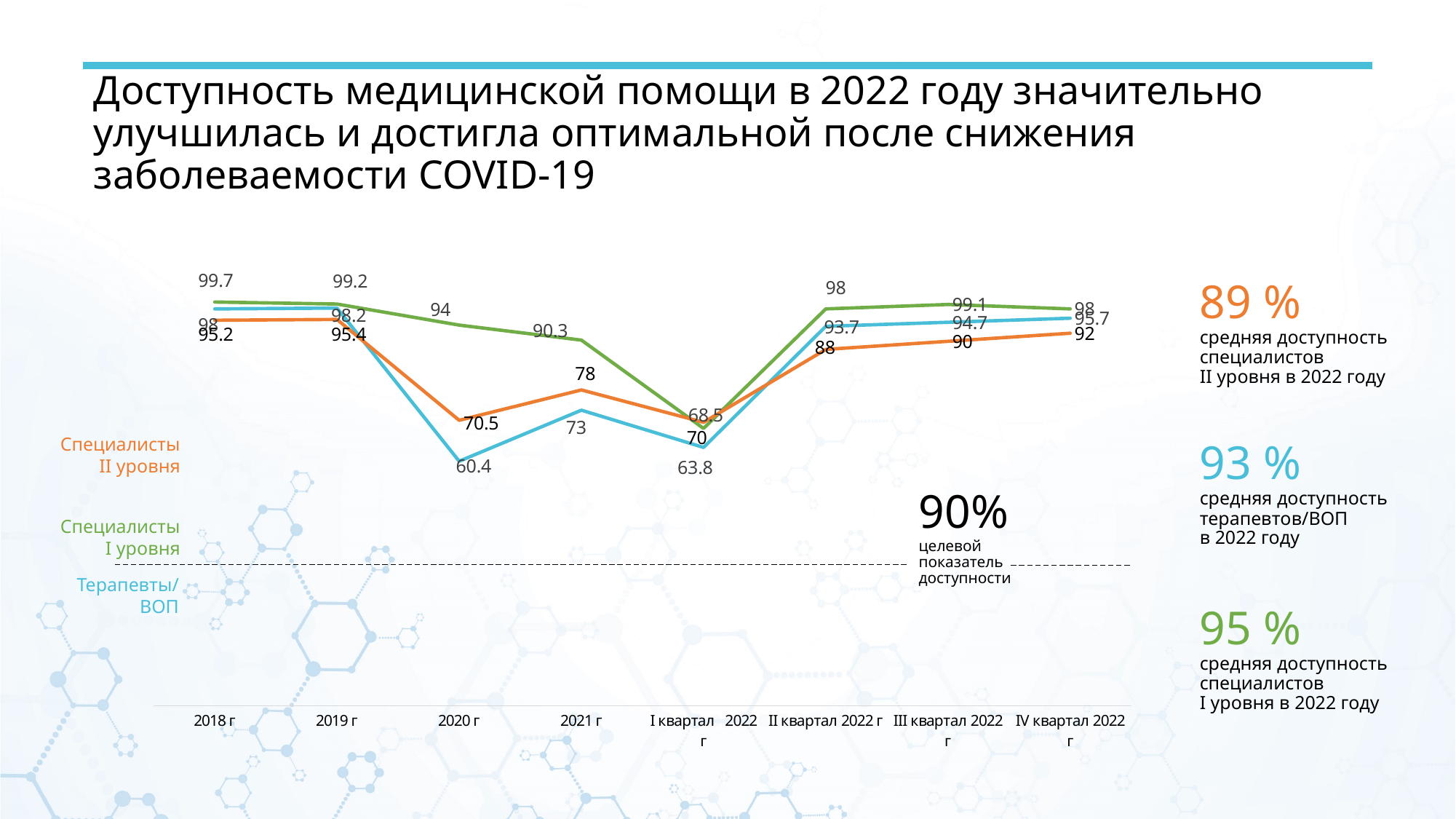
In which period does the Терапевты/ВОП line reach its lowest value? 2020 г What is the value for Специалисты I уровня in I квартал 2022 г? 68.5 By how much did the value for Специалисты II уровня increase from II квартал 2022 г to IV квартал 2022 г? 4 What is the value for Терапевты/ВОП in 2020 г? 60.4 How many time points are shown along the x axis of the chart? 8 How many series are plotted on the chart? 3 What is the value for Специалисты II уровня in II квартал 2022 г? 88 What kind of chart is shown on the slide? Line chart What is the value for Специалисты I уровня in 2021 г? 90.3 What target accessibility value (целевой показатель доступности) is marked on the chart? 90% In III квартал 2022 г, which is higher: Специалисты I уровня or Специалисты II уровня? Специалисты I уровня In which period does the Специалисты I уровня line reach its highest value? 2018 г